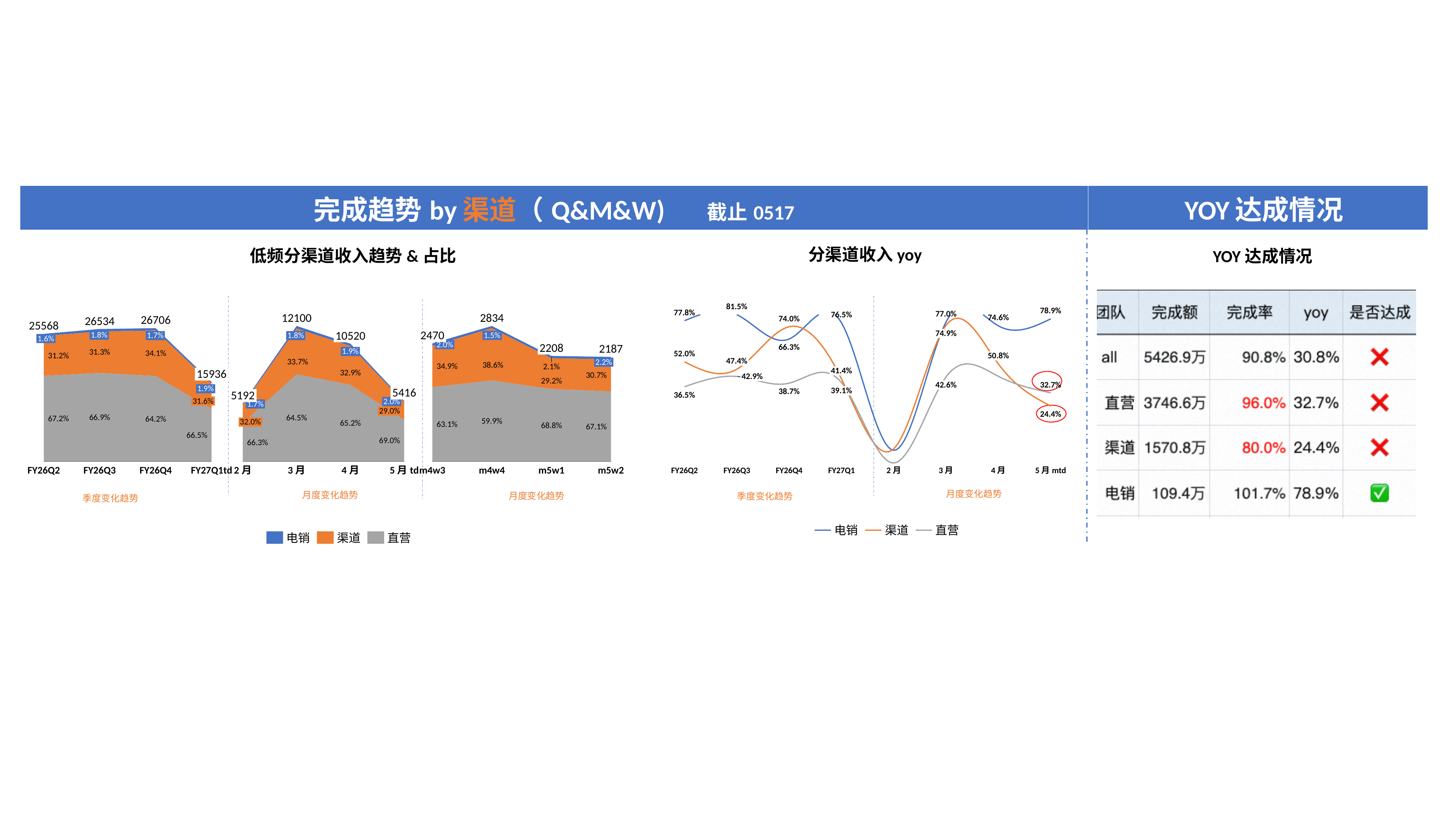
What kind of chart is the one titled 低频分渠道收入趋势 & 占比? stacked area chart How many categories are shown on the x axis of the chart titled 分渠道收入 yoy? 8 In the chart titled 分渠道收入 yoy, what is the 渠道 value at 5月 mtd? 24.4% How many series does the legend of the chart titled 低频分渠道收入趋势 & 占比 list? 3 In the chart titled 低频分渠道收入趋势 & 占比, which month among 2月, 3月, 4月 and 5月td has the highest total? 3月 In the chart titled 低频分渠道收入趋势 & 占比, which is larger, the total for m4w4 or the total for m5w1? m4w4 What kind of chart is the one titled 分渠道收入 yoy? line chart In the chart titled 分渠道收入 yoy, what is the 电销 value at FY26Q3? 81.5% In the chart titled 低频分渠道收入趋势 & 占比, what is the difference between the FY26Q3 total and the FY26Q2 total? 966 In the chart titled 低频分渠道收入趋势 & 占比, what share does 直营 have in FY26Q2? 67.2% In the chart titled 分渠道收入 yoy, which series has the highest value at FY27Q1? 电销 In the chart titled 低频分渠道收入趋势 & 占比, what is the total value shown for FY26Q4? 26706